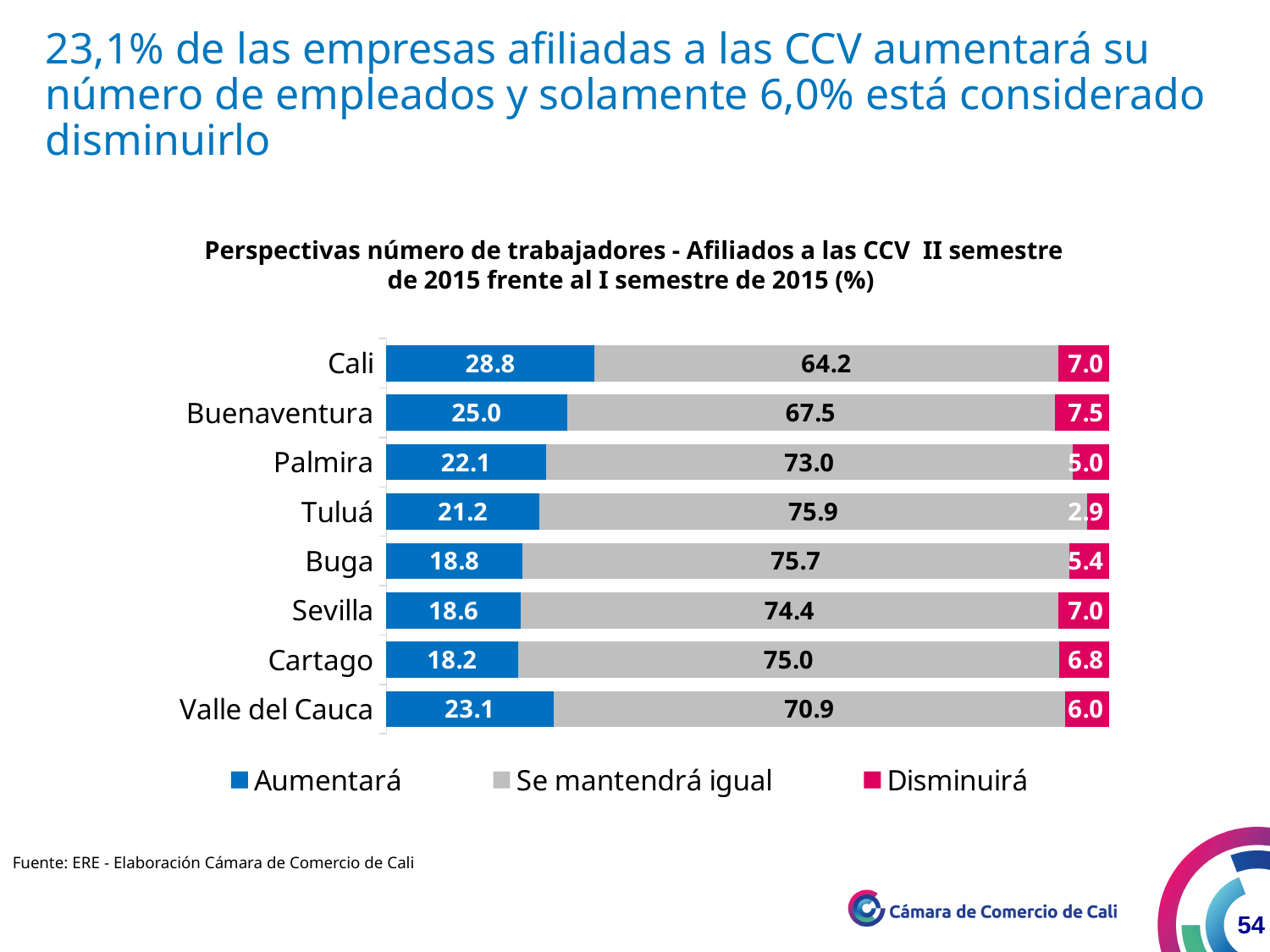
How many categories are shown on the chart? 8 How many series does the legend list? 3 Which is larger, the 'Se mantendrá igual' value for Palmira or for Buga? Buga Which category has the lowest 'Disminuirá' value? Tuluá What is the 'Se mantendrá igual' value for Tuluá? 75.9 What is the difference between the 'Aumentará' values for Cali and Valle del Cauca? 5.7 What is the 'Disminuirá' value for Buenaventura? 7.5 What kind of chart is shown on the slide? Stacked bar chart Which category has the highest 'Aumentará' value? Cali What is the 'Aumentará' value for Cali? 28.8 Which category has the lowest 'Aumentará' value? Cartago What is the total of the stacked bar for Sevilla? 100.0